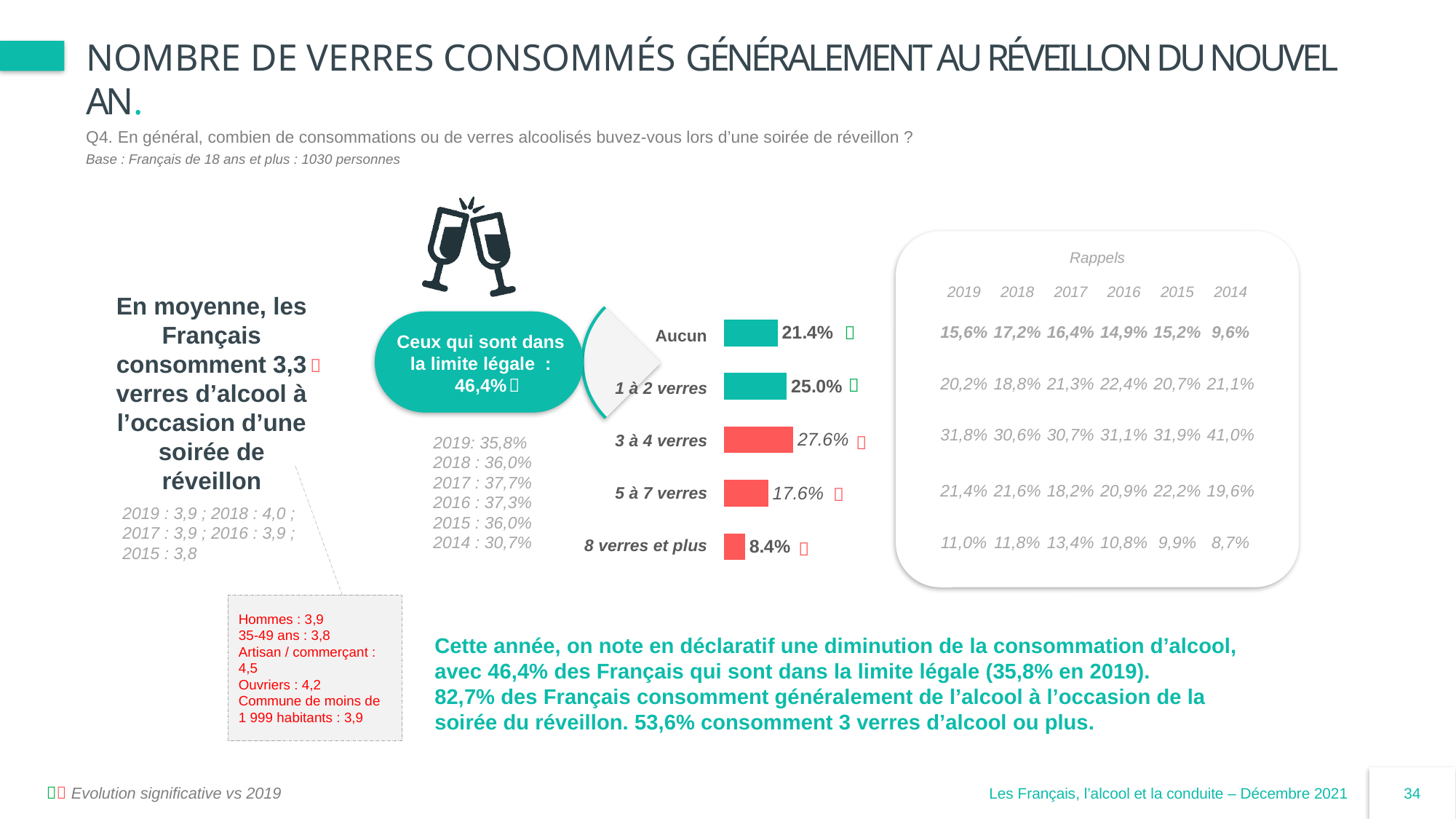
What is the value shown for "3 à 4 verres"? 27.6% What percentage of respondents answered "Aucun" in the bar chart? 21.4% What is the value shown for "8 verres et plus"? 8.4% What kind of chart is used to show the number of glasses consumed? Bar chart What is the combined value of "3 à 4 verres", "5 à 7 verres" and "8 verres et plus"? 53.6% Which category has the highest value in the bar chart? 3 à 4 verres What is the value shown for "5 à 7 verres"? 17.6% What colour are the bars for "Aucun" and "1 à 2 verres"? Teal Which category has the lowest value in the bar chart? 8 verres et plus What is the difference between the values for "1 à 2 verres" and "Aucun"? 3.6% Which is larger: the value for "5 à 7 verres" or the value for "Aucun"? Aucun How many categories are shown in the bar chart? 5